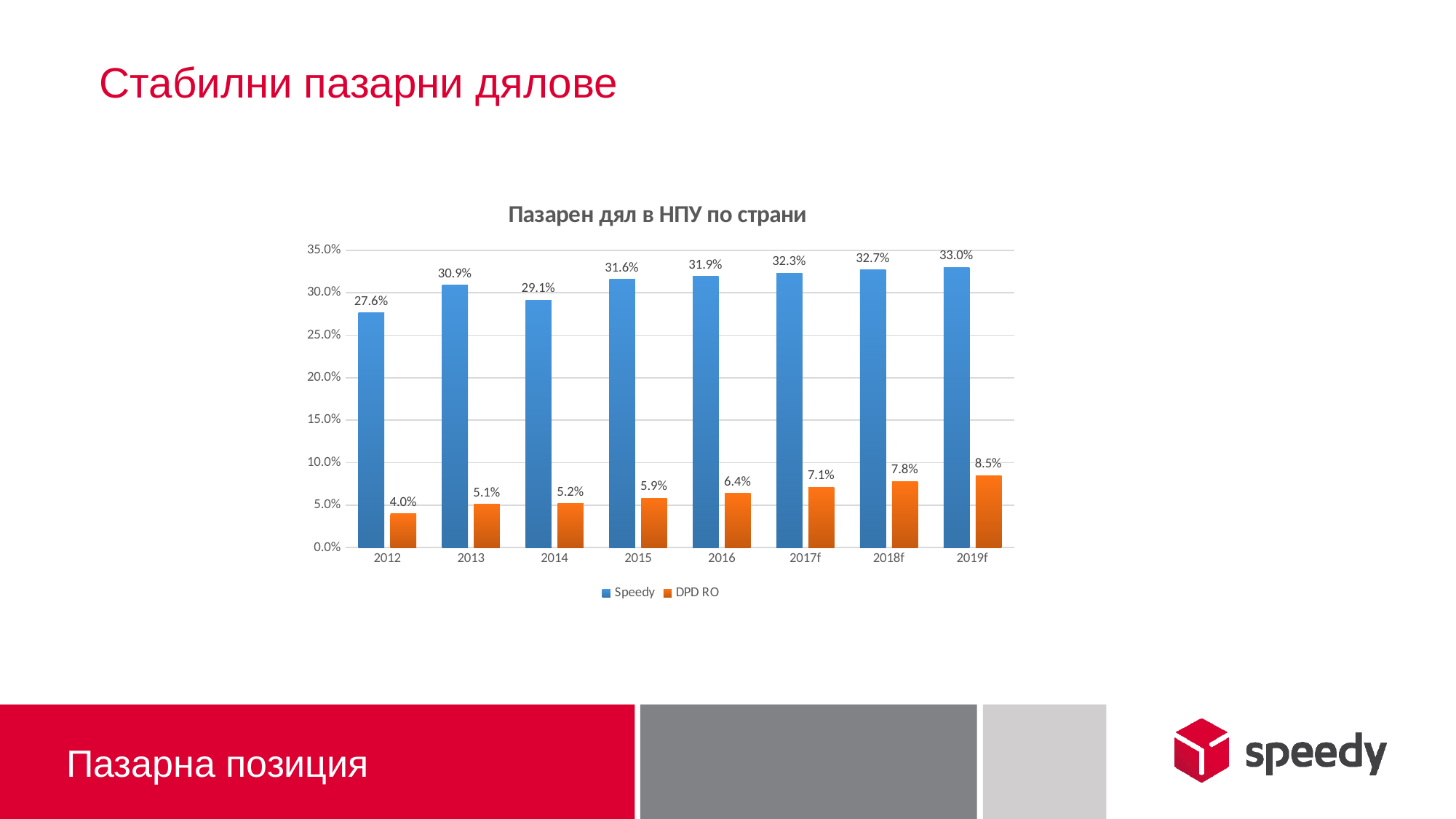
How many series does the legend list? 2 What kind of chart is shown? bar chart How many years are shown on the x axis? 8 In which year is the DPD RO value highest? 2019f What is the DPD RO value for 2017f? 7.1% What is the difference between the Speedy value in 2019f and in 2012? 5.4% What is the Speedy value for 2014? 29.1% Which is larger, the Speedy value in 2013 or in 2014? 2013 Is the DPD RO value for 2018f greater or less than 10.0%? less In which year is the Speedy value lowest? 2012 Do the DPD RO values rise or fall from 2012 to 2019f? rise What is the difference between the Speedy and DPD RO values in 2016? 25.5%